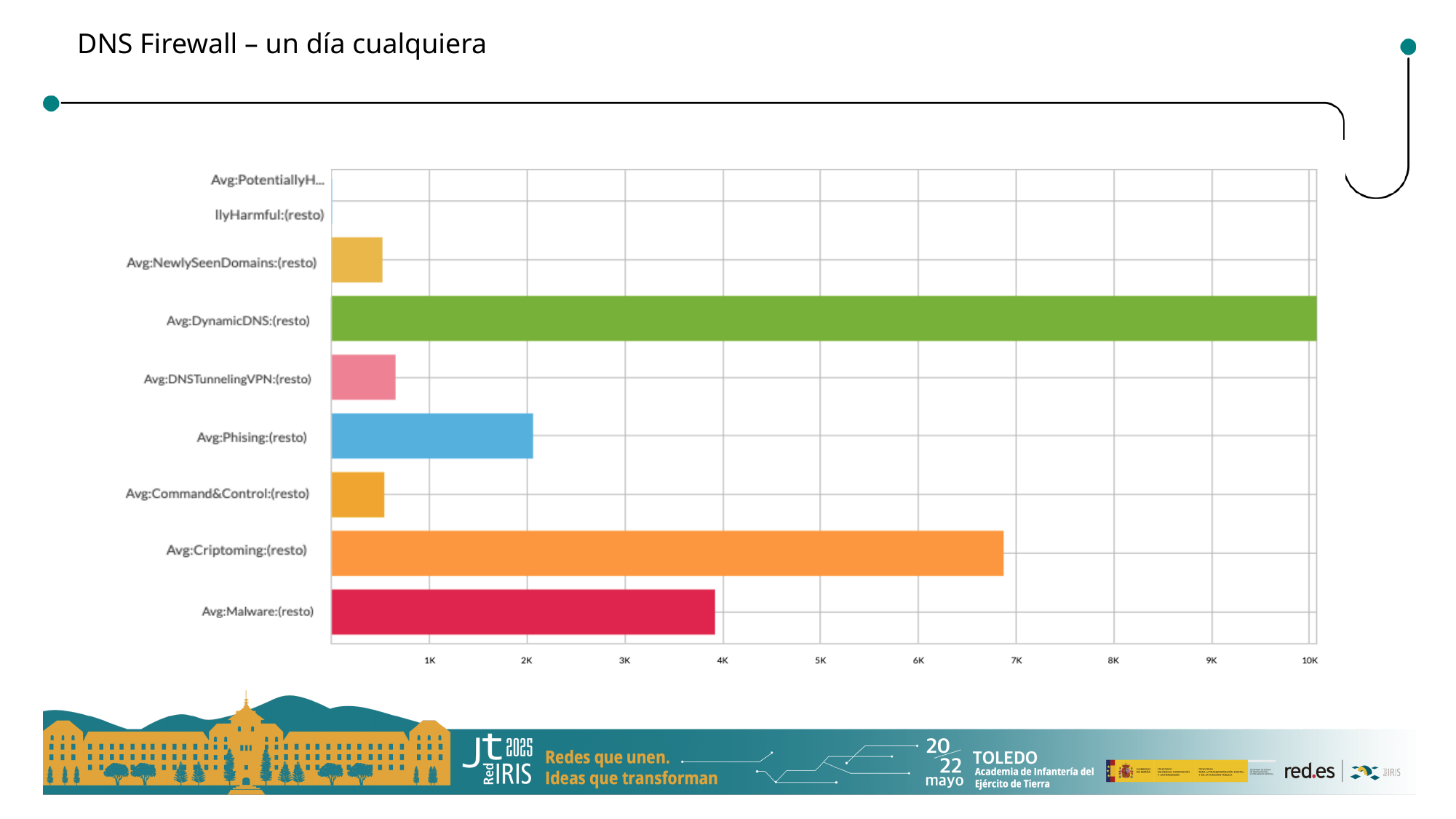
How many categories are listed on the vertical axis of the chart? 9 Which category has the highest value? Avg:DynamicDNS:(resto) What kind of chart is shown on the slide? bar chart Is the value for Avg:Criptoming:(resto) greater or less than 7K? less Which is larger, the value for Avg:Criptoming:(resto) or the value for Avg:Malware:(resto)? Avg:Criptoming:(resto) Is the value for Avg:Malware:(resto) greater or less than 3K? greater Is the value for Avg:Criptoming:(resto) greater or less than 6K? greater Which is larger, the value for Avg:Phising:(resto) or the value for Avg:DNSTunnelingVPN:(resto)? Avg:Phising:(resto) What is the title of the slide containing the chart? DNS Firewall – un día cualquiera